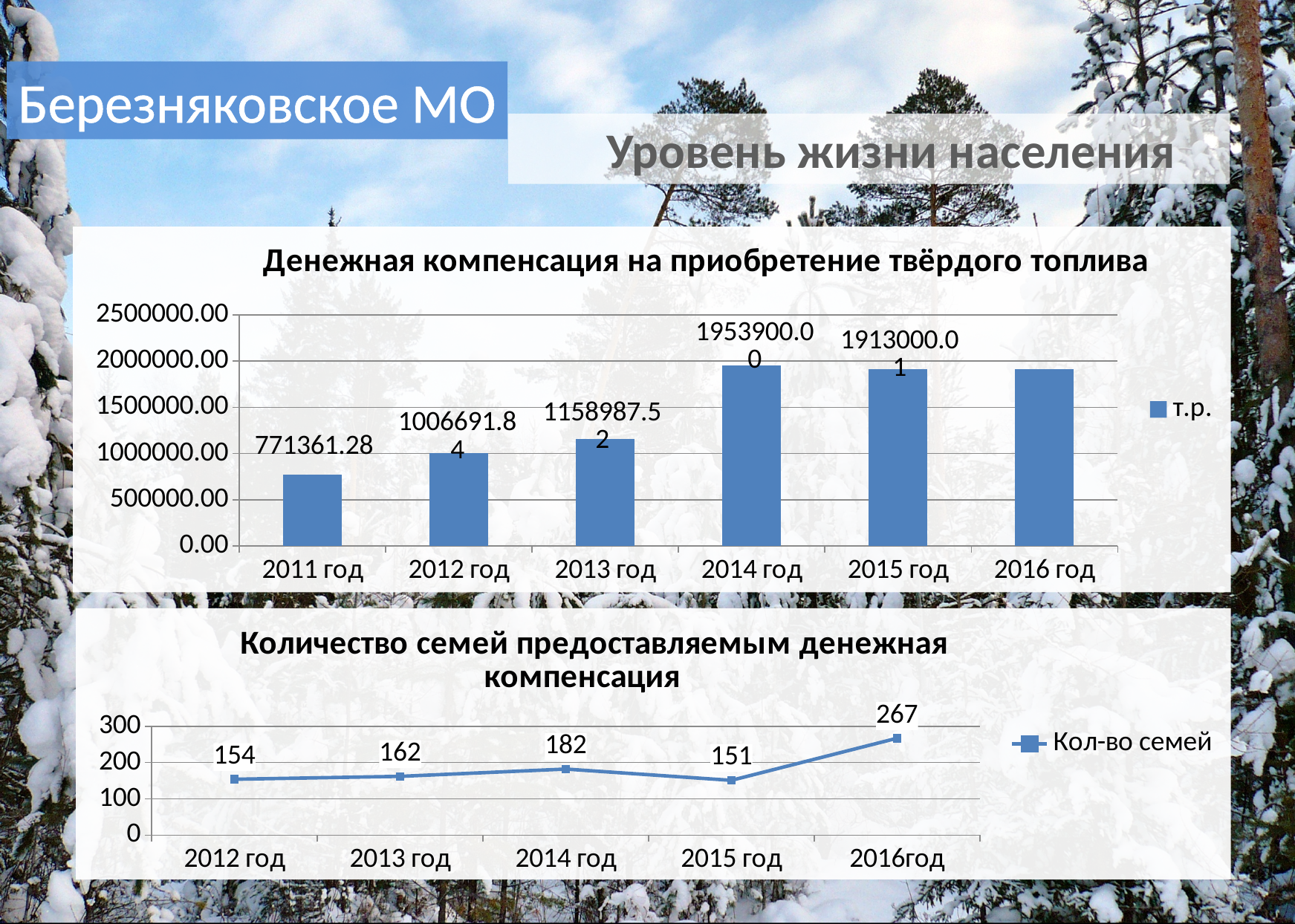
What kind of chart is 'Денежная компенсация на приобретение твёрдого топлива'? bar chart What is the legend entry in the chart 'Количество семей предоставляемым денежная компенсация'? Кол-во семей In the chart 'Денежная компенсация на приобретение твёрдого топлива', is the value for 2016 год greater or less than 1500000.00? greater In the chart 'Денежная компенсация на приобретение твёрдого топлива', how many years are shown on the x axis? 6 In the chart 'Денежная компенсация на приобретение твёрдого топлива', which year has the lowest value? 2011 год What kind of chart is 'Количество семей предоставляемым денежная компенсация'? line chart In the chart 'Денежная компенсация на приобретение твёрдого топлива', what is the value for 2014 год? 1953900.00 In the chart 'Количество семей предоставляемым денежная компенсация', what is the value for 2016год? 267 In the chart 'Денежная компенсация на приобретение твёрдого топлива', which is larger: the value for 2012 год or 2013 год? 2013 год In the chart 'Количество семей предоставляемым денежная компенсация', what is the difference between the values for 2016год and 2015 год? 116 In the chart 'Денежная компенсация на приобретение твёрдого топлива', what is the value for 2011 год? 771361.28 In the chart 'Количество семей предоставляемым денежная компенсация', which year has the lowest value? 2015 год